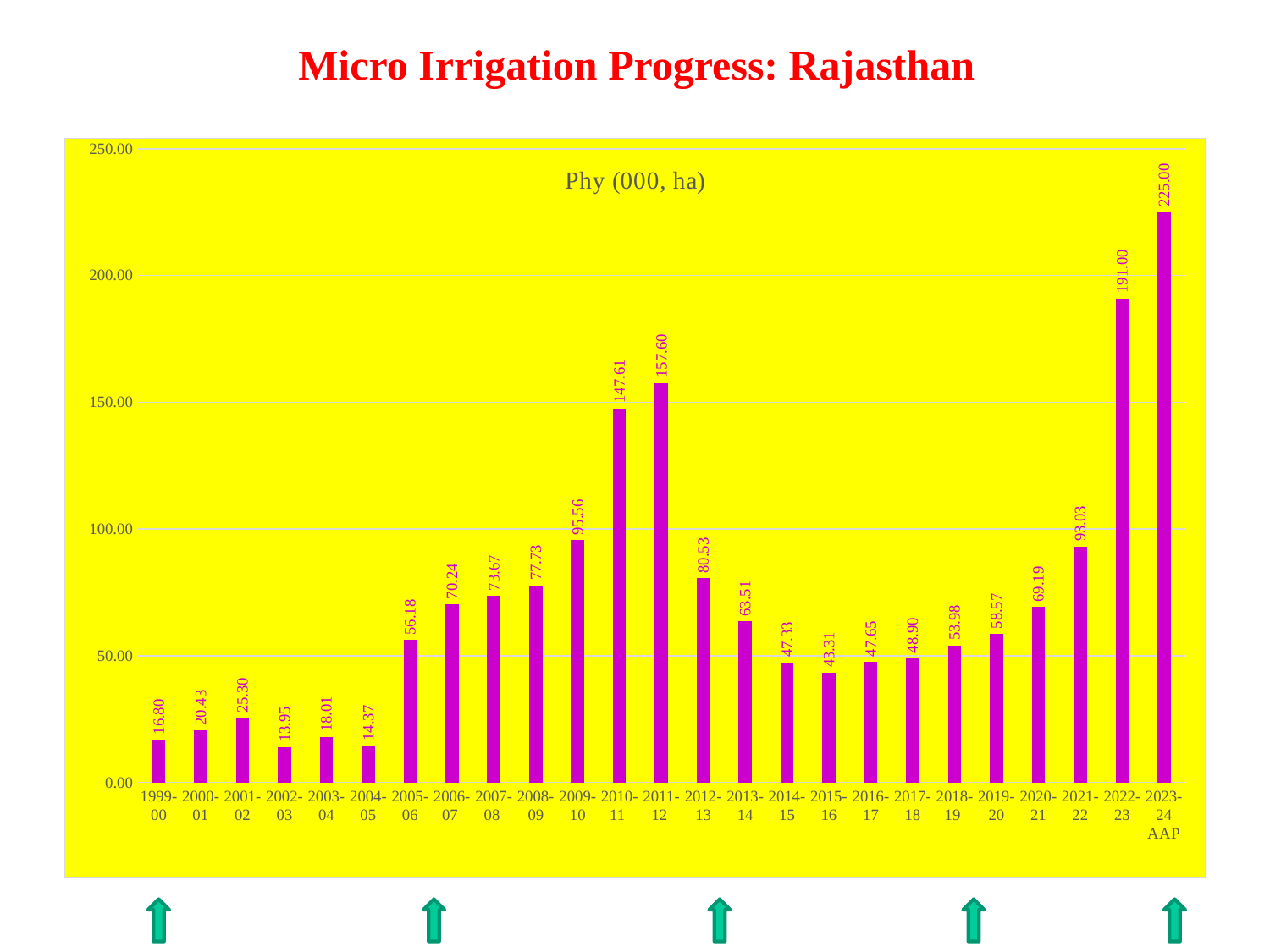
Which year has the highest value? 2023-24 AAP Is the value for 2021-22 greater or less than 100? less How many years are shown on the x axis? 25 Which is larger, the value for 2012-13 or the value for 2013-14? 2012-13 Do the values rise or fall from 2011-12 to 2015-16? fall What is the value for 2022-23? 191.00 What is the difference between the values for 2023-24 AAP and 2022-23? 34.00 What kind of chart is shown on the slide? bar chart What is the value for 2005-06? 56.18 Which year has the lowest value? 2002-03 What is the value for 2010-11? 147.61 What is the difference between the values for 2011-12 and 2010-11? 9.99